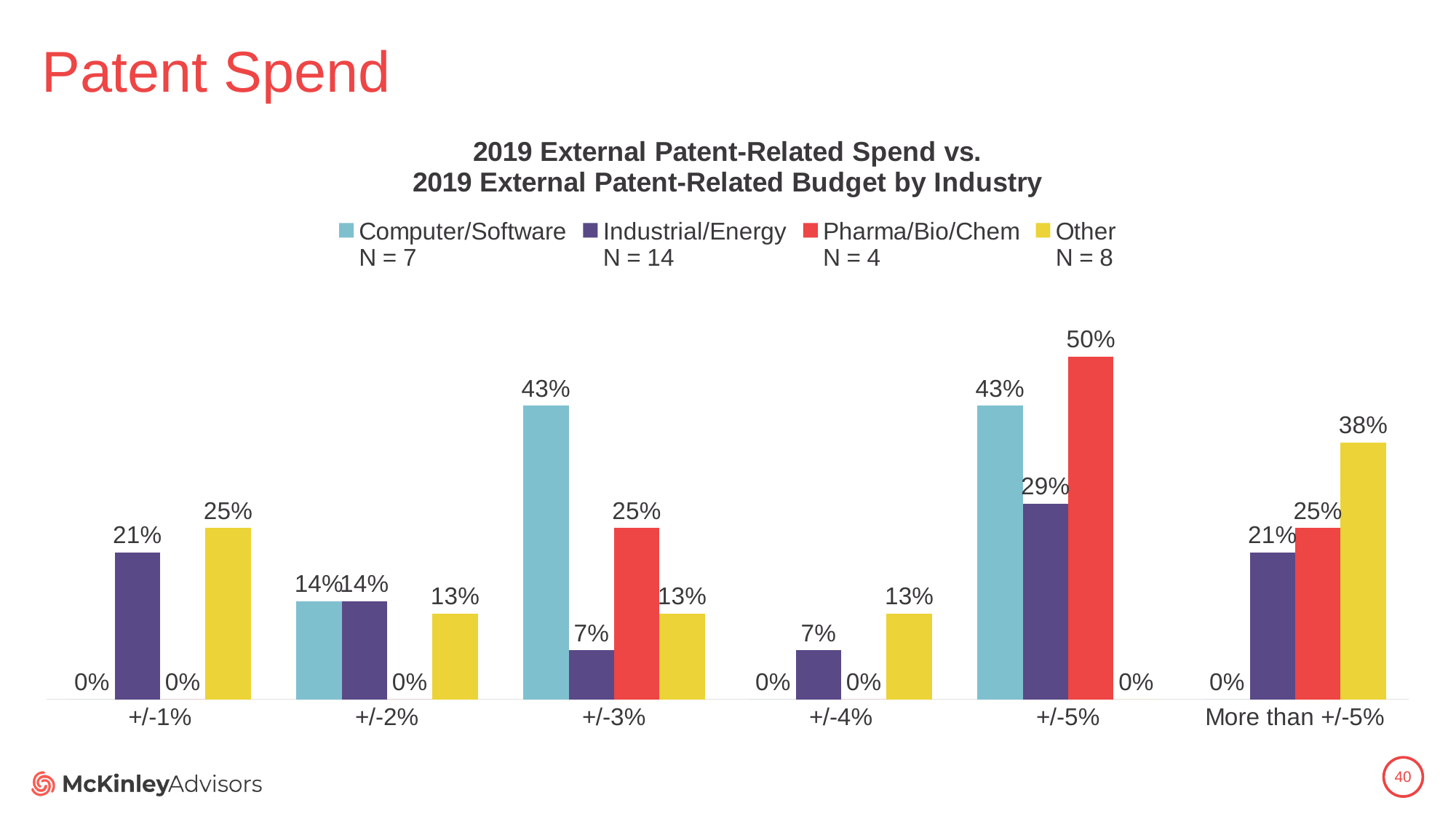
What is the sample size (N) shown in the legend for Industrial/Energy? N = 14 What is the value for Other in the +/-4% category? 13% What is the difference between the Computer/Software and Industrial/Energy values in the +/-3% category? 36% What type of chart is shown on the slide? bar chart What is the value for Industrial/Energy in the +/-1% category? 21% What is the value for Pharma/Bio/Chem in the +/-5% category? 50% In which category does Computer/Software have its lowest non-zero value? +/-2% What is the value for Other in the More than +/-5% category? 38% Which series has the highest value in the +/-5% category? Pharma/Bio/Chem How many series does the legend list? 4 Which is larger in the More than +/-5% category: Industrial/Energy or Pharma/Bio/Chem? Pharma/Bio/Chem How many categories are shown along the x axis? 6